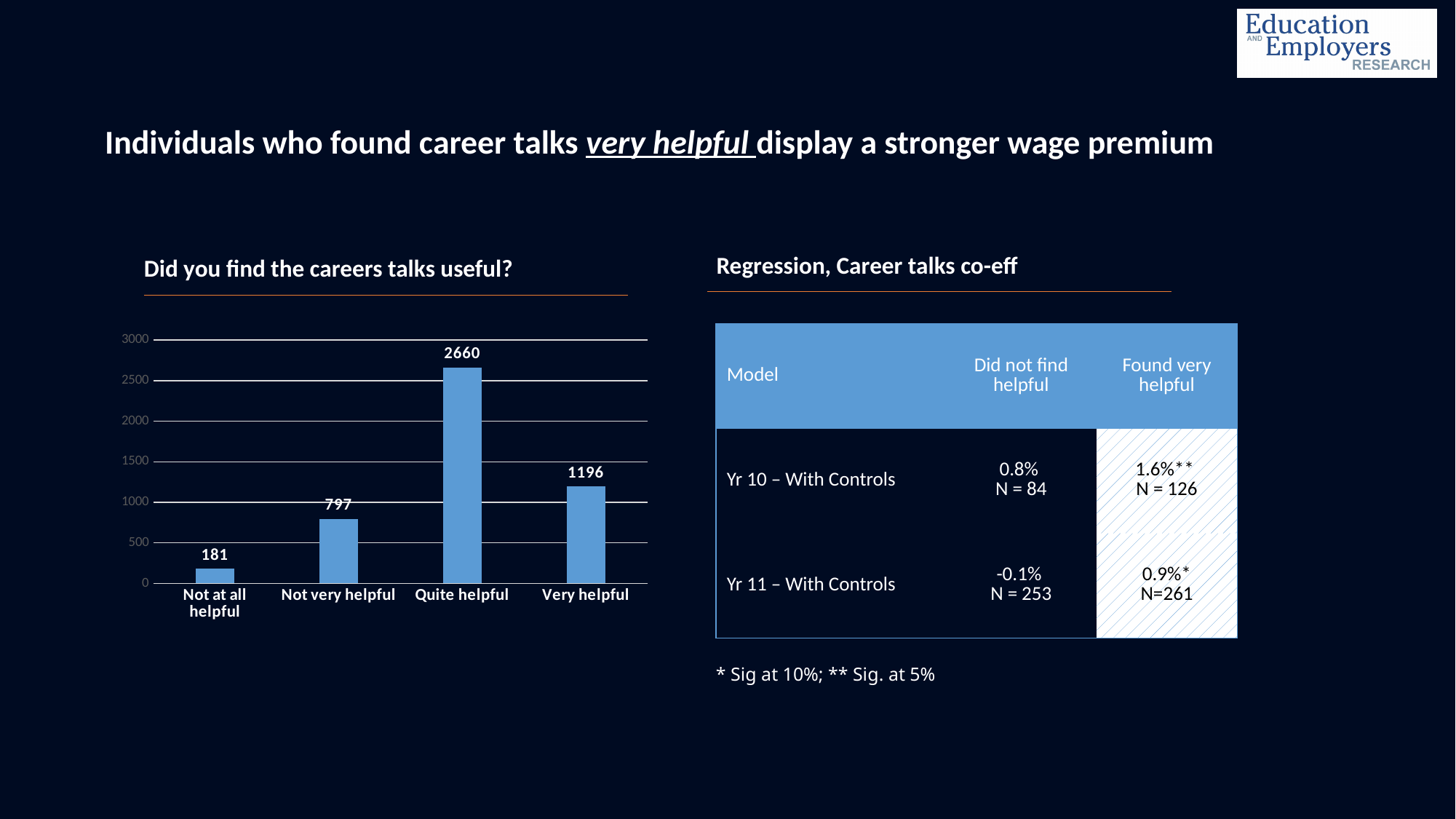
What is the difference between the values for 'Quite helpful' and 'Very helpful' in the chart 'Did you find the careers talks useful?' 1464 How many categories are shown in the chart 'Did you find the careers talks useful?' 4 What is the value for 'Very helpful' in the chart 'Did you find the careers talks useful?' 1196 What kind of chart is 'Did you find the careers talks useful?' bar chart Is the value for 'Not very helpful' greater or less than 1000 in the chart 'Did you find the careers talks useful?' less What is the value for 'Quite helpful' in the chart 'Did you find the careers talks useful?' 2660 Which category has the highest value in the chart 'Did you find the careers talks useful?' Quite helpful What is the title of the chart on the left of the slide? Did you find the careers talks useful? Which is larger in the chart 'Did you find the careers talks useful?': 'Not very helpful' or 'Very helpful'? Very helpful Which category has the lowest value in the chart 'Did you find the careers talks useful?' Not at all helpful What is the value for 'Not very helpful' in the chart 'Did you find the careers talks useful?' 797 What is the value for 'Not at all helpful' in the chart 'Did you find the careers talks useful?' 181